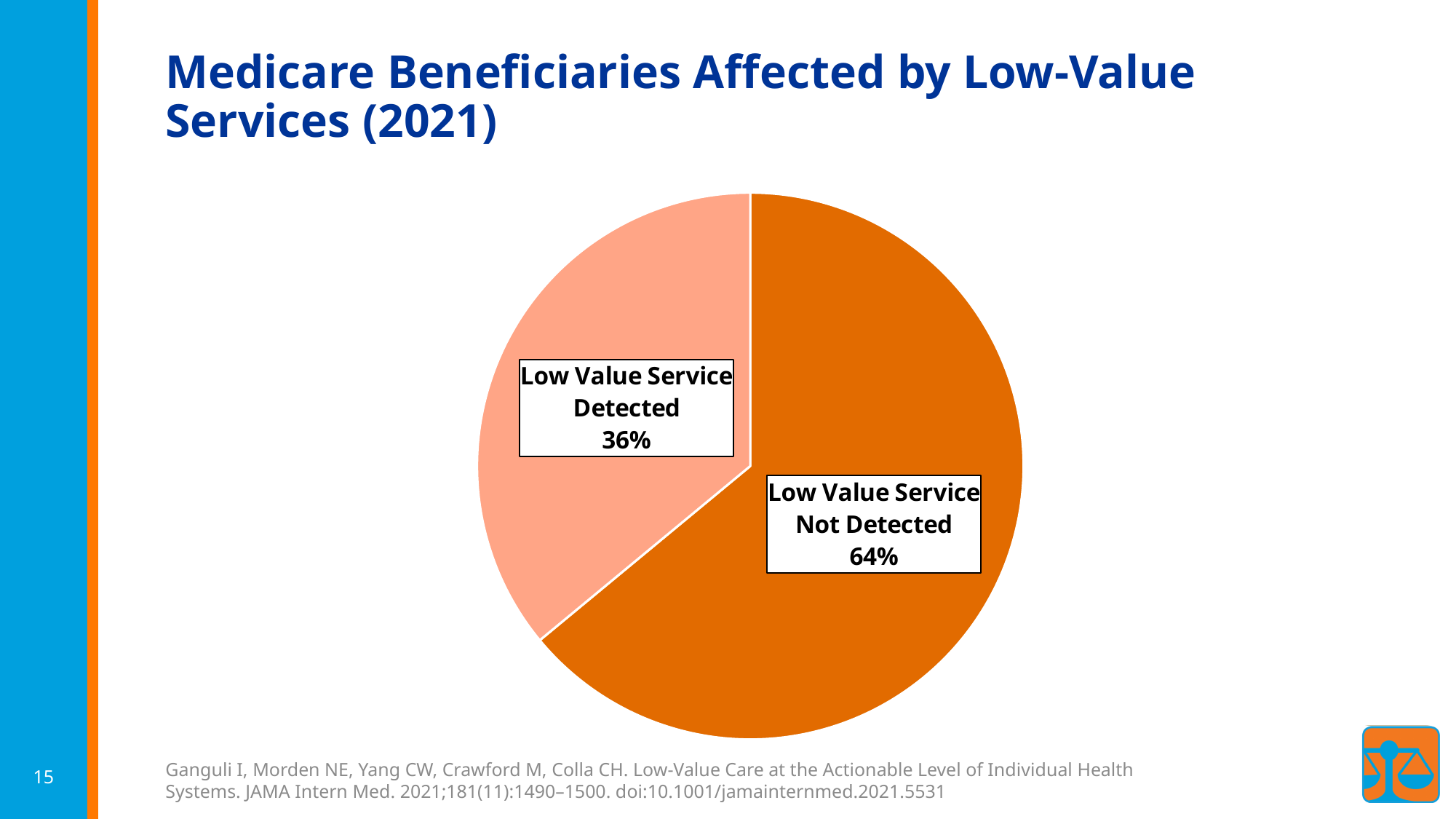
What kind of chart is shown on the slide? Pie chart Which slice of the pie is the smallest? Low Value Service Detected Which slice of the pie is the largest? Low Value Service Not Detected Which slice is shown in the lighter orange colour? Low Value Service Detected What is the difference in percentage points between the 'Low Value Service Not Detected' and 'Low Value Service Detected' slices? 28 How many slices does the pie chart have? 2 What share of the pie does the 'Low Value Service Detected' slice represent? 36% Is the share of beneficiaries with a low value service detected greater or less than 50%? less What is the title of the slide containing the chart? Medicare Beneficiaries Affected by Low-Value Services (2021) What percentage of Medicare beneficiaries had a low value service detected? 36% Which is larger: the share with a low value service detected or the share with no low value service detected? Low Value Service Not Detected What percentage of Medicare beneficiaries had no low value service detected? 64%